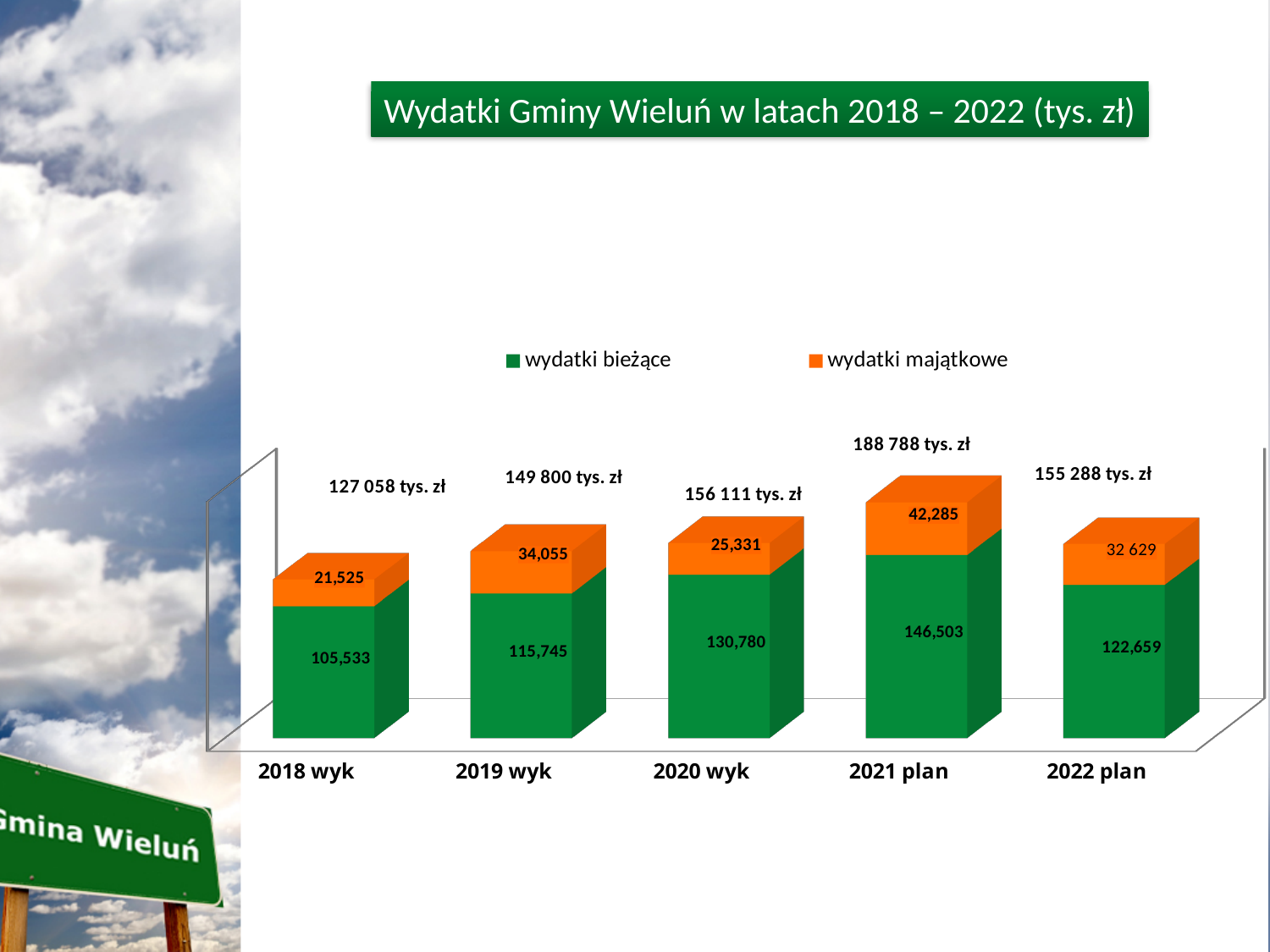
What is the total of the stacked bar for 2021 plan? 188 788 tys. zł What is the value of wydatki majątkowe for 2021 plan? 42,285 What is the value of wydatki majątkowe for 2022 plan? 32 629 Which category has the lowest value for wydatki majątkowe? 2018 wyk Which category has the highest value for wydatki bieżące? 2021 plan Which is larger: wydatki majątkowe for 2019 wyk or for 2020 wyk? 2019 wyk What is the difference between wydatki bieżące for 2019 wyk and 2018 wyk? 10,212 Which colour represents wydatki majątkowe in the chart? Orange How many categories are shown on the x axis? 5 What kind of chart is shown on the slide? Stacked bar chart How many series does the legend list? 2 What is the value of wydatki bieżące for 2020 wyk? 130,780